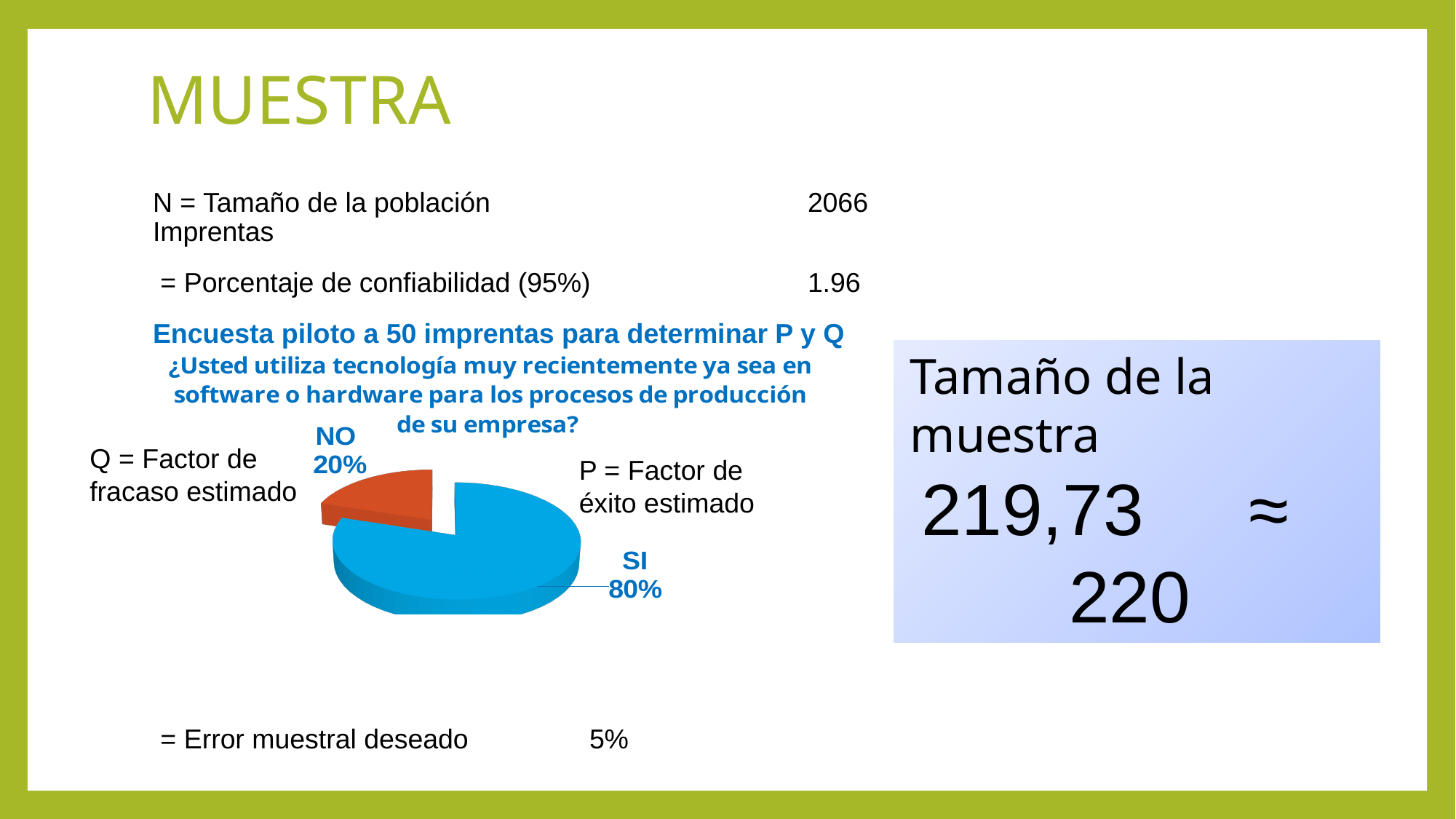
Which slice of the pie chart is the smallest? NO What colour is the NO slice of the pie chart? orange What colour is the SI slice of the pie chart? blue How many slices does the pie chart have? 2 Which slice of the pie chart is the largest? SI What kind of chart is shown on the slide? pie chart What percentage does the SI slice of the pie chart represent? 80% What percentage does the NO slice of the pie chart represent? 20% What share of the pie does the NO slice take? 20% Which is larger in the pie chart, SI or NO? SI What is the difference in percentage points between the SI and NO slices? 60